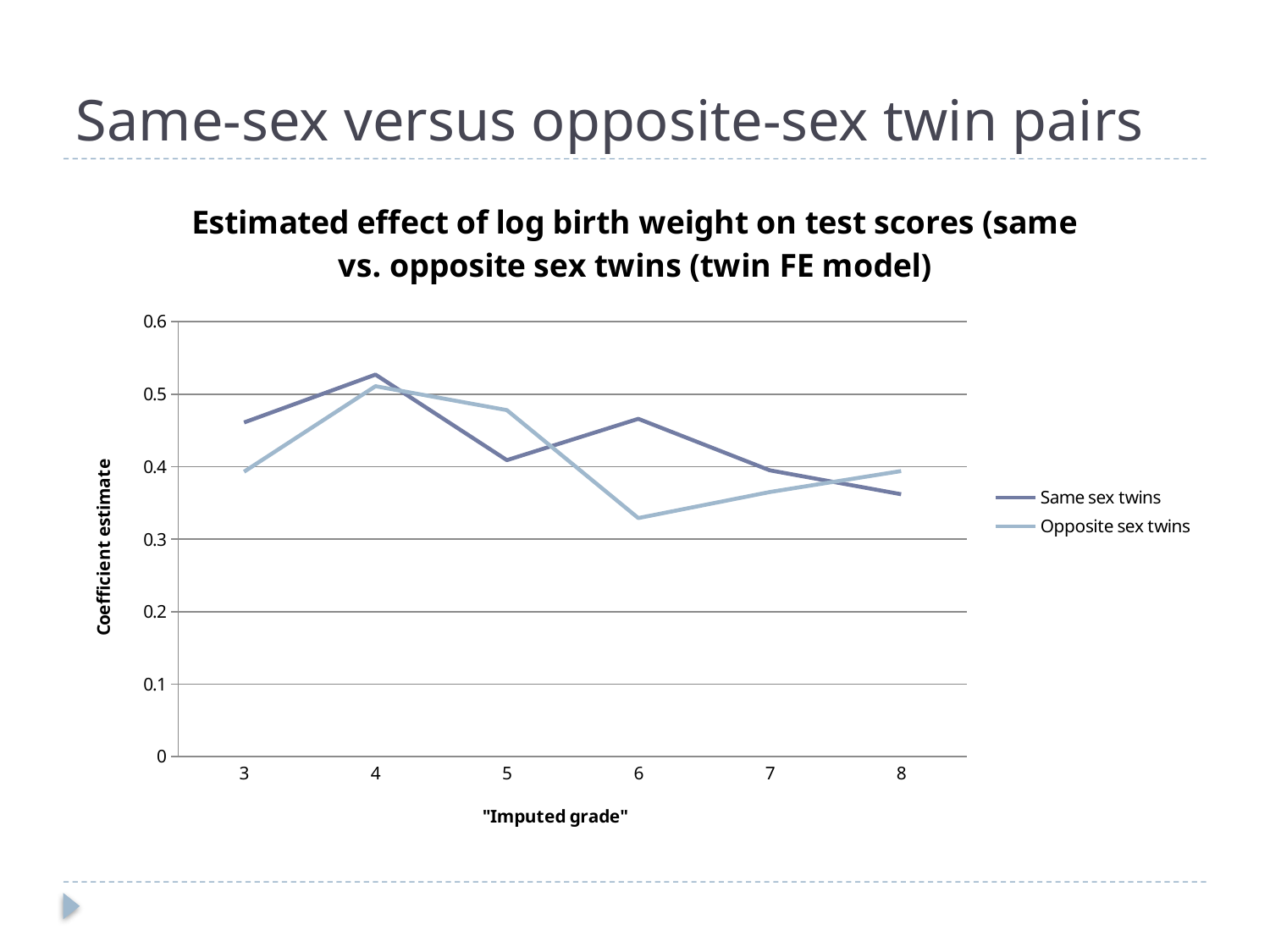
Is the value for Opposite sex twins at imputed grade 6 greater or less than 0.4? less What is the label on the vertical axis of the chart? Coefficient estimate Is the value for Same sex twins at imputed grade 8 greater or less than 0.4? less Is the value for Same sex twins at imputed grade 4 greater or less than 0.5? greater How many series does the legend list? 2 At which imputed grade does the Same sex twins line reach its lowest value? 8 At which imputed grade does the Same sex twins line reach its highest value? 4 How many imputed grades are plotted along the x axis? 6 At imputed grade 5, which series has the higher coefficient estimate, Same sex twins or Opposite sex twins? Opposite sex twins At imputed grade 6, which series has the higher coefficient estimate, Same sex twins or Opposite sex twins? Same sex twins At which imputed grade does the Opposite sex twins line reach its lowest value? 6 What kind of chart is shown on the slide? Line chart